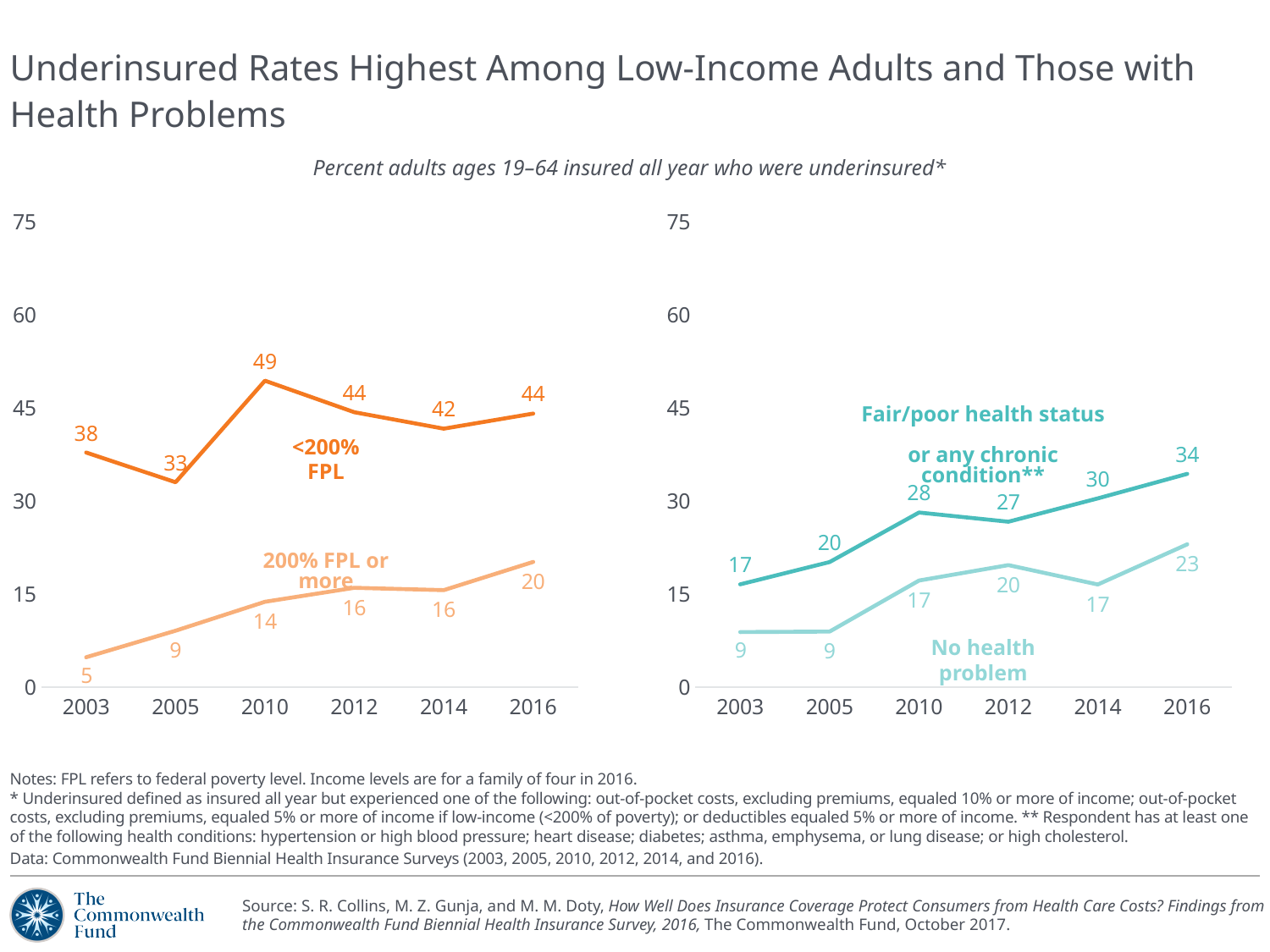
On the left chart, what is the value for adults at 200% FPL or more in 2003? 5 On the right chart, which group has the larger value in 2014: fair/poor health status or any chronic condition, or no health problem? Fair/poor health status or any chronic condition On the right chart, what is the value for adults with fair/poor health status or any chronic condition in 2016? 34 On the right chart, what is the value for adults with no health problem in 2012? 20 How many years are shown on the x axis of the left chart? 6 On the left chart, in which year is the value for adults under 200% FPL highest? 2010 On the right chart, what is the difference between the 2016 and 2003 values for adults with no health problem? 14 On the left chart, what is the value for adults under 200% FPL in 2010? 49 On the left chart, does the value for adults at 200% FPL or more generally rise or fall from 2003 to 2016? Rise What type of chart is shown on the right side of the slide? Line chart On the left chart, what is the difference between the <200% FPL and 200% FPL or more values in 2016? 24 On the right chart, in which year is the value for adults with fair/poor health status or any chronic condition lowest? 2003